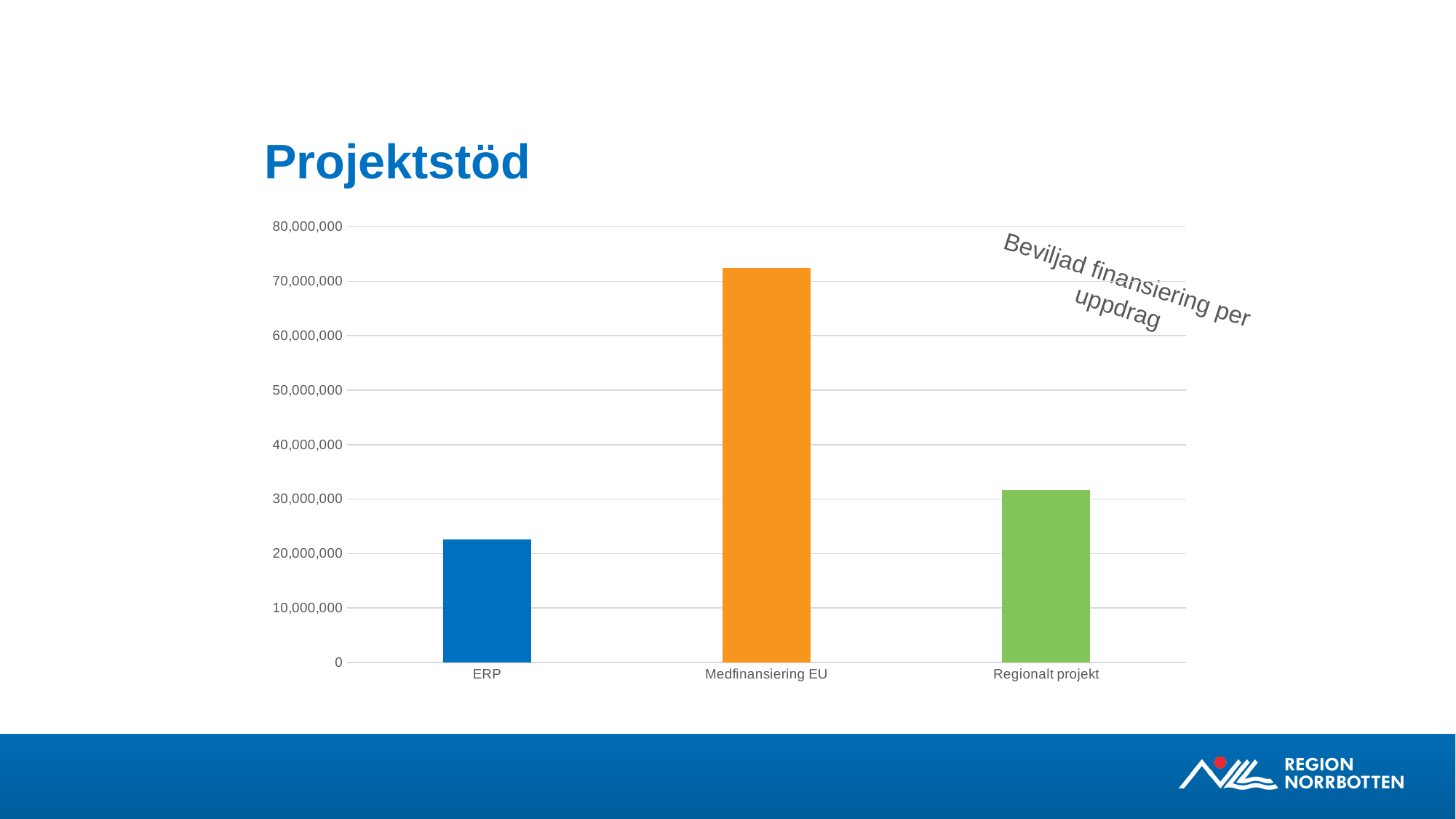
Which is larger, the value for ERP or the value for Regionalt projekt? Regionalt projekt Is the value for Medfinansiering EU greater or less than 70,000,000? greater Is the value for ERP greater or less than 30,000,000? less What kind of chart is shown on the slide? Bar chart Is the value for Regionalt projekt greater or less than 40,000,000? less How many categories are shown on the x axis of the chart? 3 Which is larger, the value for Medfinansiering EU or the value for Regionalt projekt? Medfinansiering EU Which category has the lowest value in the chart? ERP Which category has the highest value in the chart? Medfinansiering EU